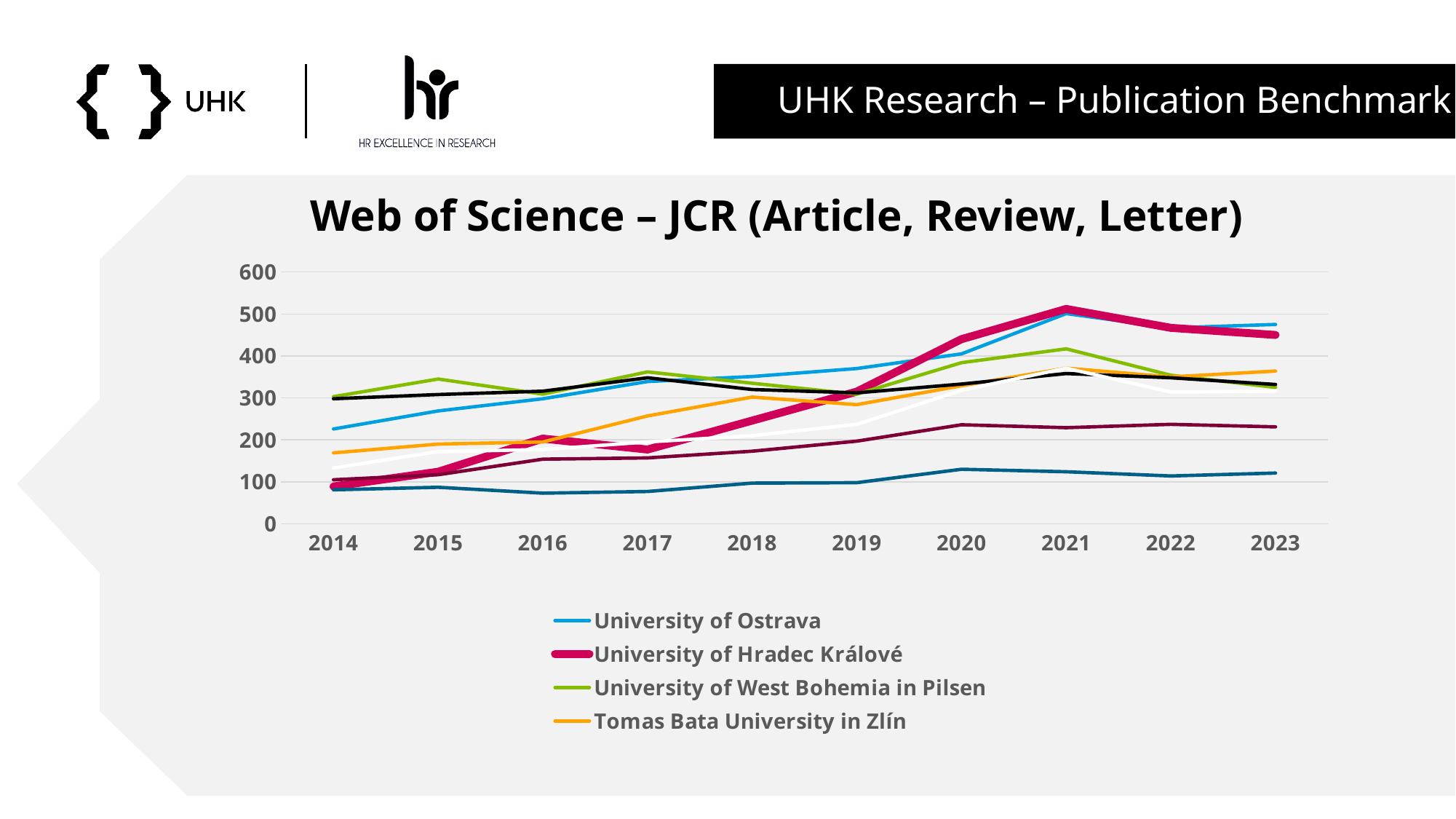
How many series does the legend list? 4 Is the value for University of Hradec Králové in 2023 greater or less than 500? less Is the value for University of Ostrava in 2023 greater or less than 500? less In 2023, which is larger: University of Hradec Králové or Tomas Bata University in Zlín? University of Hradec Králové Does the University of Hradec Králové line rise or fall from 2014 to 2021? rise Is the value for Tomas Bata University in Zlín in 2023 greater or less than 300? greater Which of the legend series has the highest value in 2014? University of West Bohemia in Pilsen How many years are shown on the x axis? 10 What is the title of the chart? Web of Science – JCR (Article, Review, Letter) What kind of chart is shown on the slide? line chart